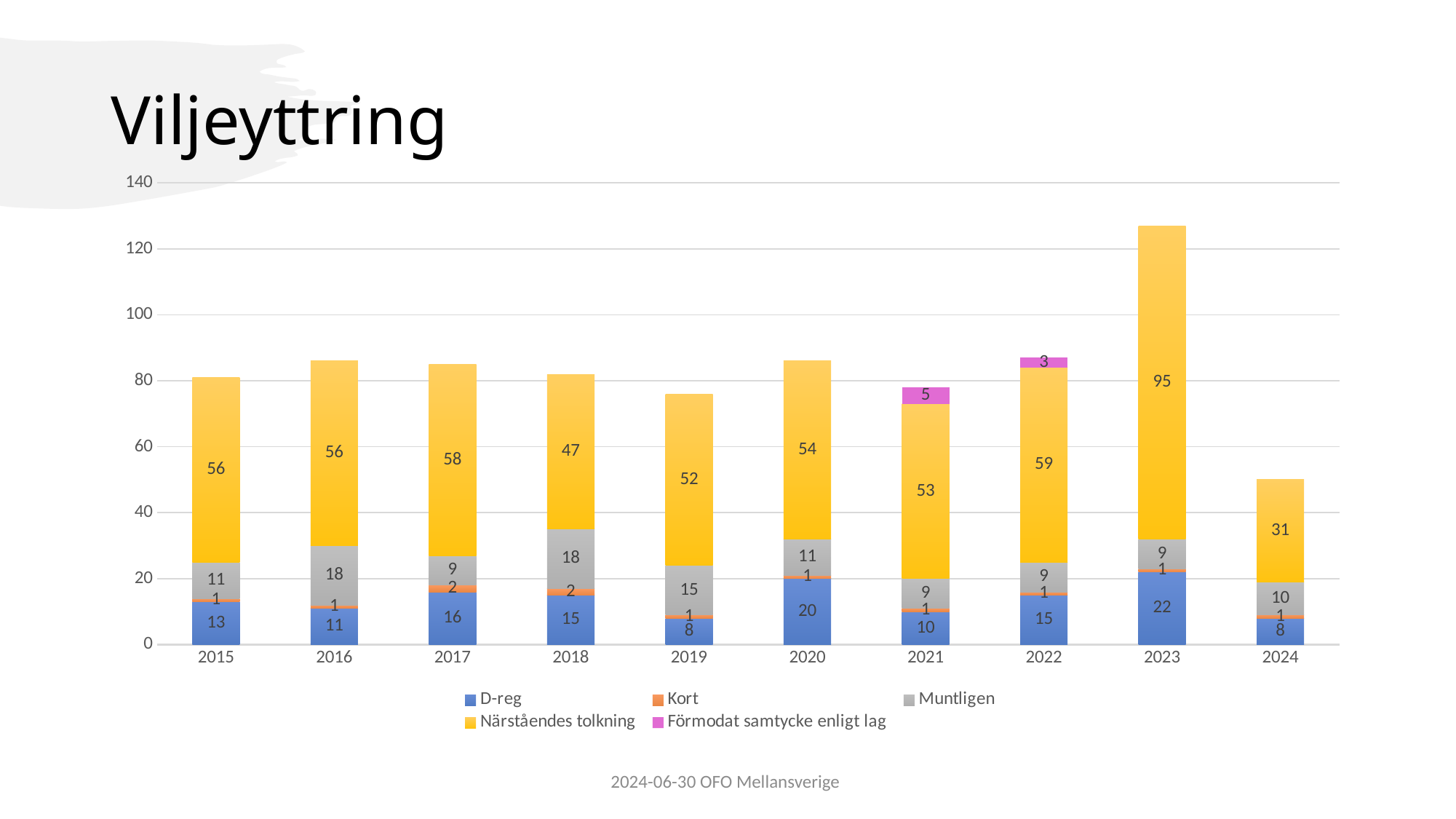
What is the value of Närståendes tolkning for 2023? 95 Which year has the highest Närståendes tolkning value? 2023 How many series does the legend list? 5 Which year has the larger D-reg value, 2020 or 2023? 2023 Is the total height of the 2023 bar greater or less than 120? greater What is the value of Förmodat samtycke enligt lag in 2021? 5 How many years are shown on the x axis? 10 What is the total of the stacked bar for 2015? 81 What is the difference between the Närståendes tolkning values for 2023 and 2024? 64 Which year has the lowest Närståendes tolkning value? 2024 What kind of chart is shown on the slide? Stacked bar chart What is the D-reg value for 2020? 20